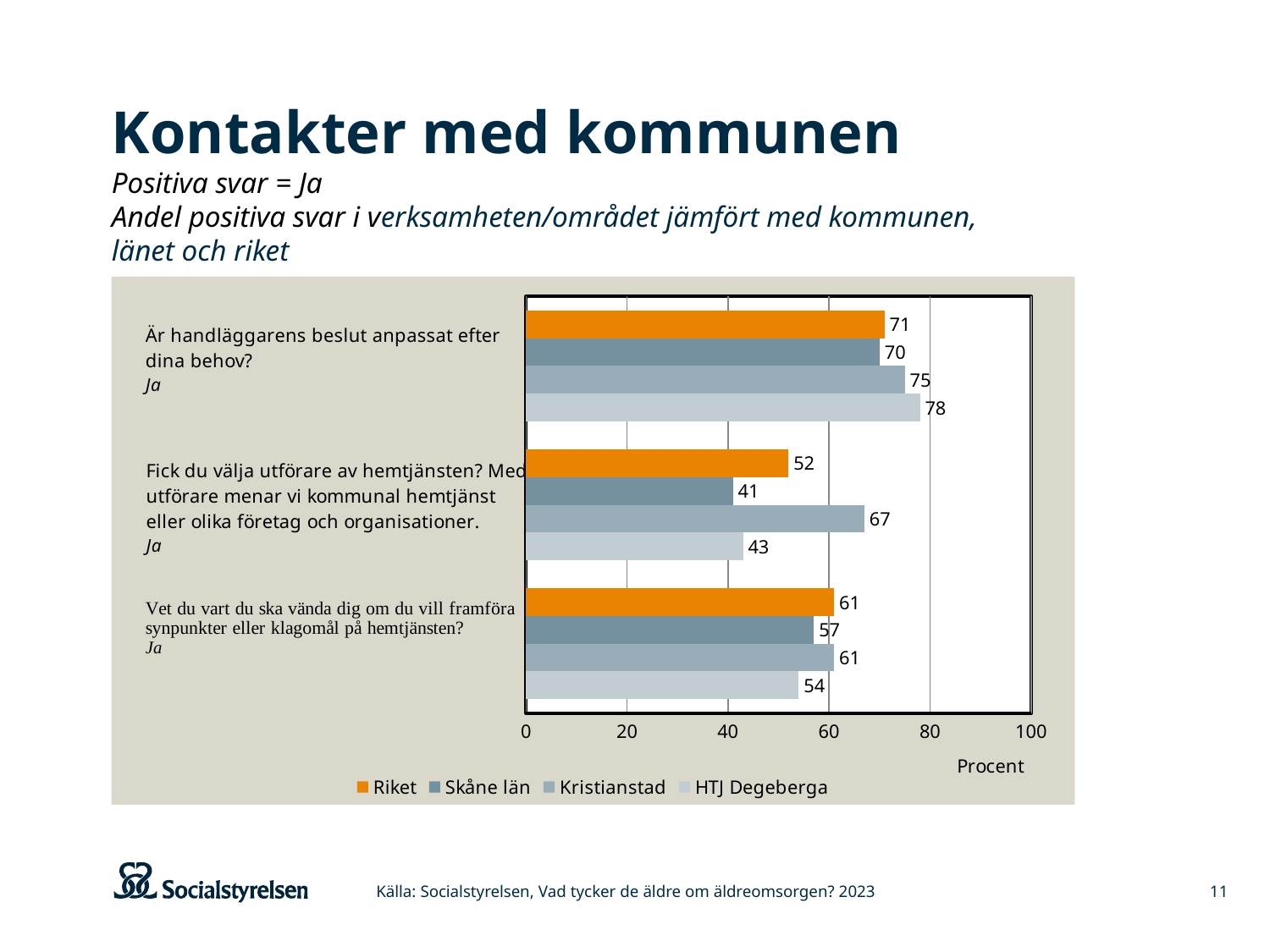
What label is shown on the horizontal axis of the chart? Procent What is the value for Skåne län on the question "Fick du välja utförare av hemtjänsten?"? 41 Which series has the lowest value on the question "Vet du vart du ska vända dig om du vill framföra synpunkter eller klagomål på hemtjänsten?"? HTJ Degeberga On the question "Är handläggarens beslut anpassat efter dina behov?", which is larger: Riket or Kristianstad? Kristianstad What is the value for Riket on the question "Vet du vart du ska vända dig om du vill framföra synpunkter eller klagomål på hemtjänsten?"? 61 What is the difference between Kristianstad and HTJ Degeberga on the question "Fick du välja utförare av hemtjänsten?"? 24 Is the value for Skåne län on the question "Är handläggarens beslut anpassat efter dina behov?" greater or less than 60? greater Which series has the highest value on the question "Fick du välja utförare av hemtjänsten?"? Kristianstad How many series does the legend list? 4 What is the value for HTJ Degeberga on the question "Är handläggarens beslut anpassat efter dina behov?"? 78 How many question categories are plotted on the chart? 3 What kind of chart is shown on the slide? bar chart